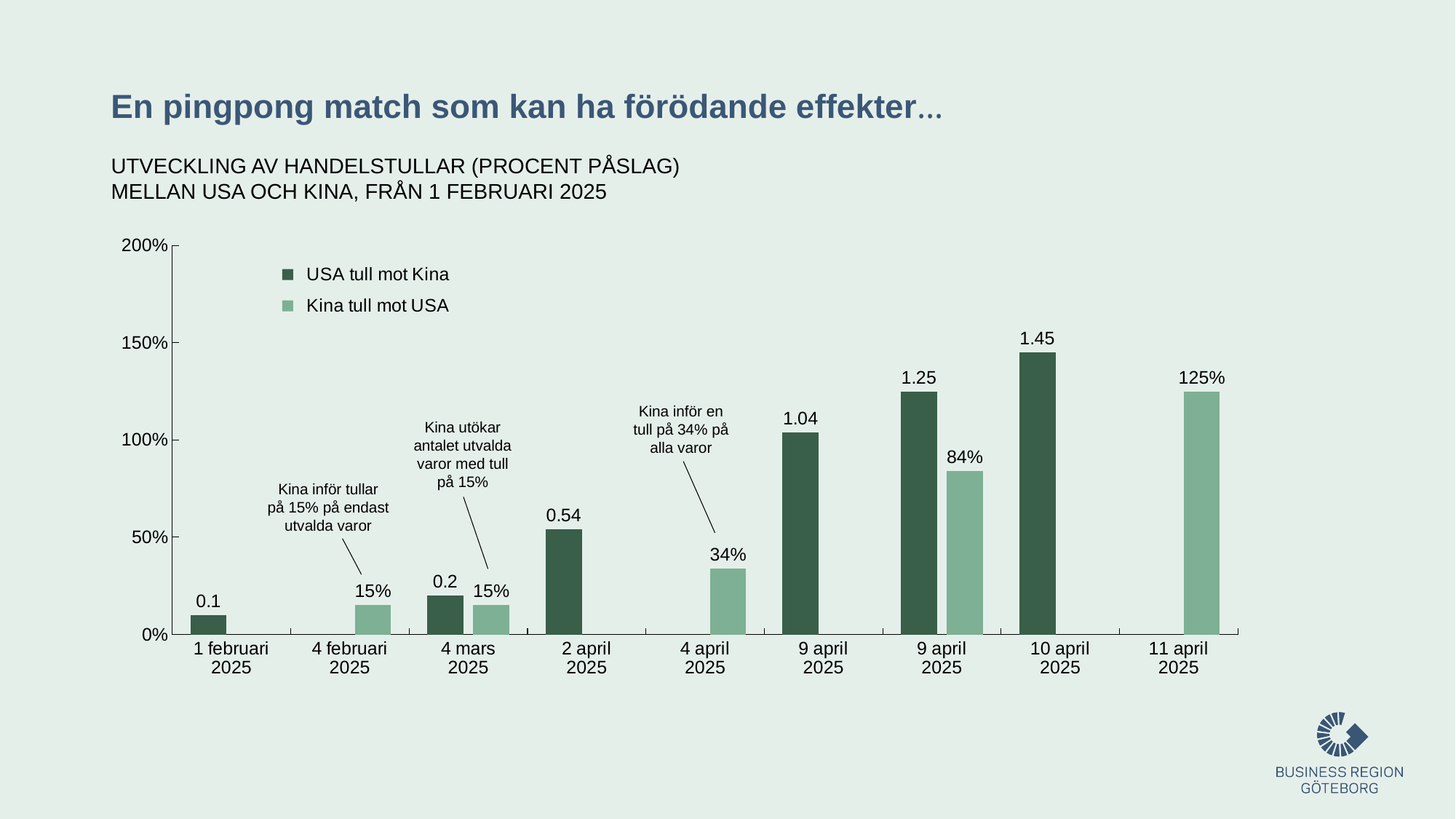
On which date is USA tull mot Kina lowest? 1 februari 2025 What is the value for Kina tull mot USA on 4 februari 2025? 15% What is the value for Kina tull mot USA on 4 april 2025? 34% What kind of chart is shown on the slide? Bar chart How many series does the legend list? 2 On which date is USA tull mot Kina highest? 10 april 2025 How many date categories are shown on the x axis? 9 On which date is Kina tull mot USA highest? 11 april 2025 What is the value for USA tull mot Kina on 2 april 2025? 0.54 Is the value for USA tull mot Kina on 10 april 2025 greater or less than 150%? less What is the value for USA tull mot Kina on 10 april 2025? 1.45 On the second 9 april 2025 category, which is larger: USA tull mot Kina or Kina tull mot USA? USA tull mot Kina